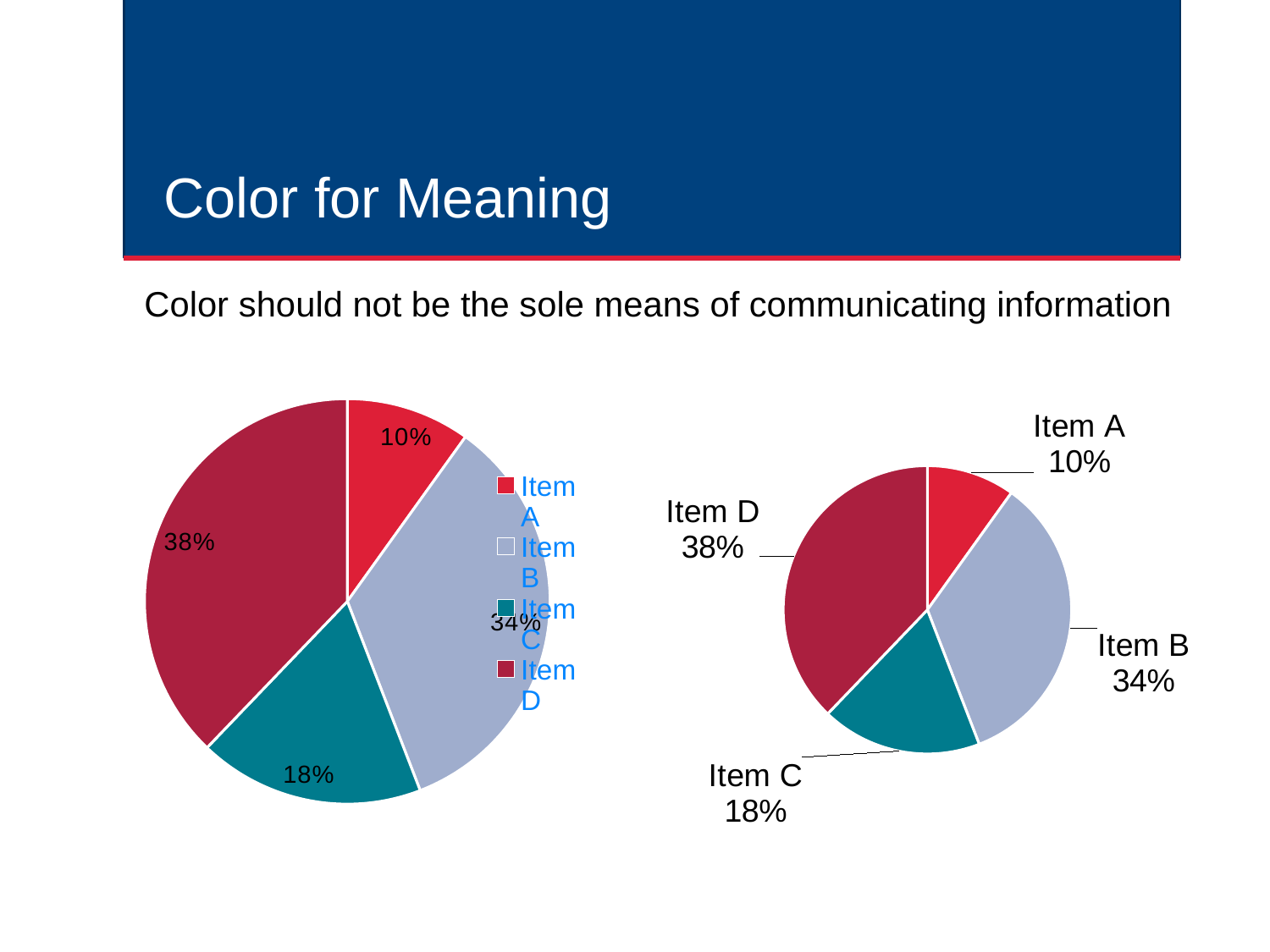
What is the title of the slide containing the two pie charts? Color for Meaning In the right pie chart, which is larger, Item B or Item C? Item B In the right pie chart, what is the value for Item A? 10% In the right pie chart, what is the value for Item B? 34% How many slices does the left pie chart have? 4 What kind of chart is shown on the right side of the slide? pie chart In the right pie chart, what is the value for Item C? 18% In the right pie chart, which item has the largest share? Item D In the right pie chart, what is the difference between the shares of Item D and Item C? 20% In the left pie chart, what share does the red slice (Item A) represent? 10% In the right pie chart, which item has the smallest share? Item A How many entries does the legend of the left pie chart list? 4